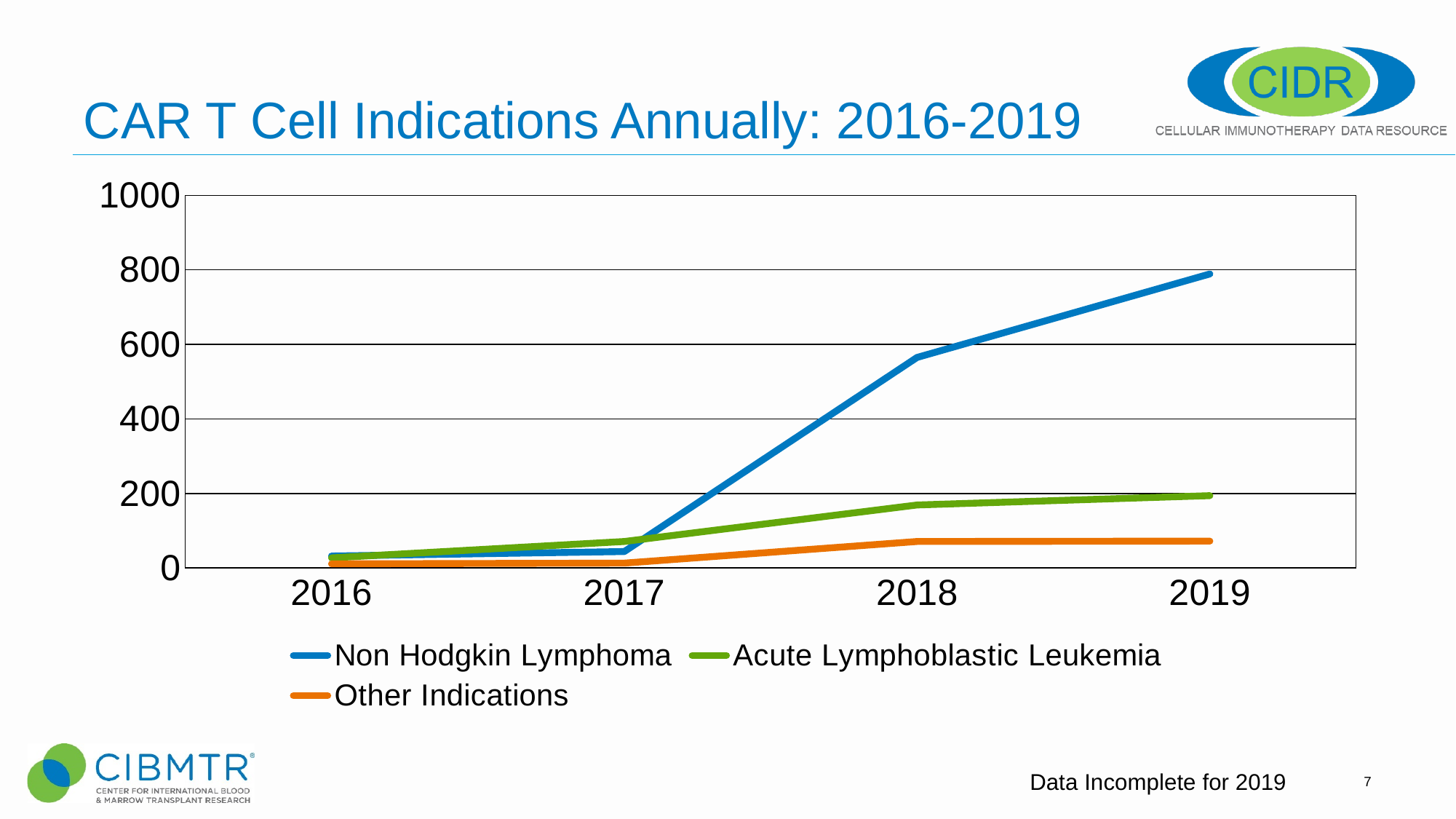
In 2018, which is larger: Non Hodgkin Lymphoma or Acute Lymphoblastic Leukemia? Non Hodgkin Lymphoma Is the value for Non Hodgkin Lymphoma in 2019 greater or less than 600? greater Is the value for Acute Lymphoblastic Leukemia in 2018 greater or less than 200? less How many years are plotted along the x axis? 4 How many series does the legend list? 3 Which series has the lowest value in 2018? Other Indications What is the title of the chart on the slide? CAR T Cell Indications Annually: 2016-2019 Does the Non Hodgkin Lymphoma line rise or fall from 2016 to 2019? rise In which year does Non Hodgkin Lymphoma reach its highest value? 2019 What kind of chart is shown on the slide? line chart Which series has the highest value in 2019? Non Hodgkin Lymphoma Is the value for Non Hodgkin Lymphoma in 2018 greater or less than 400? greater